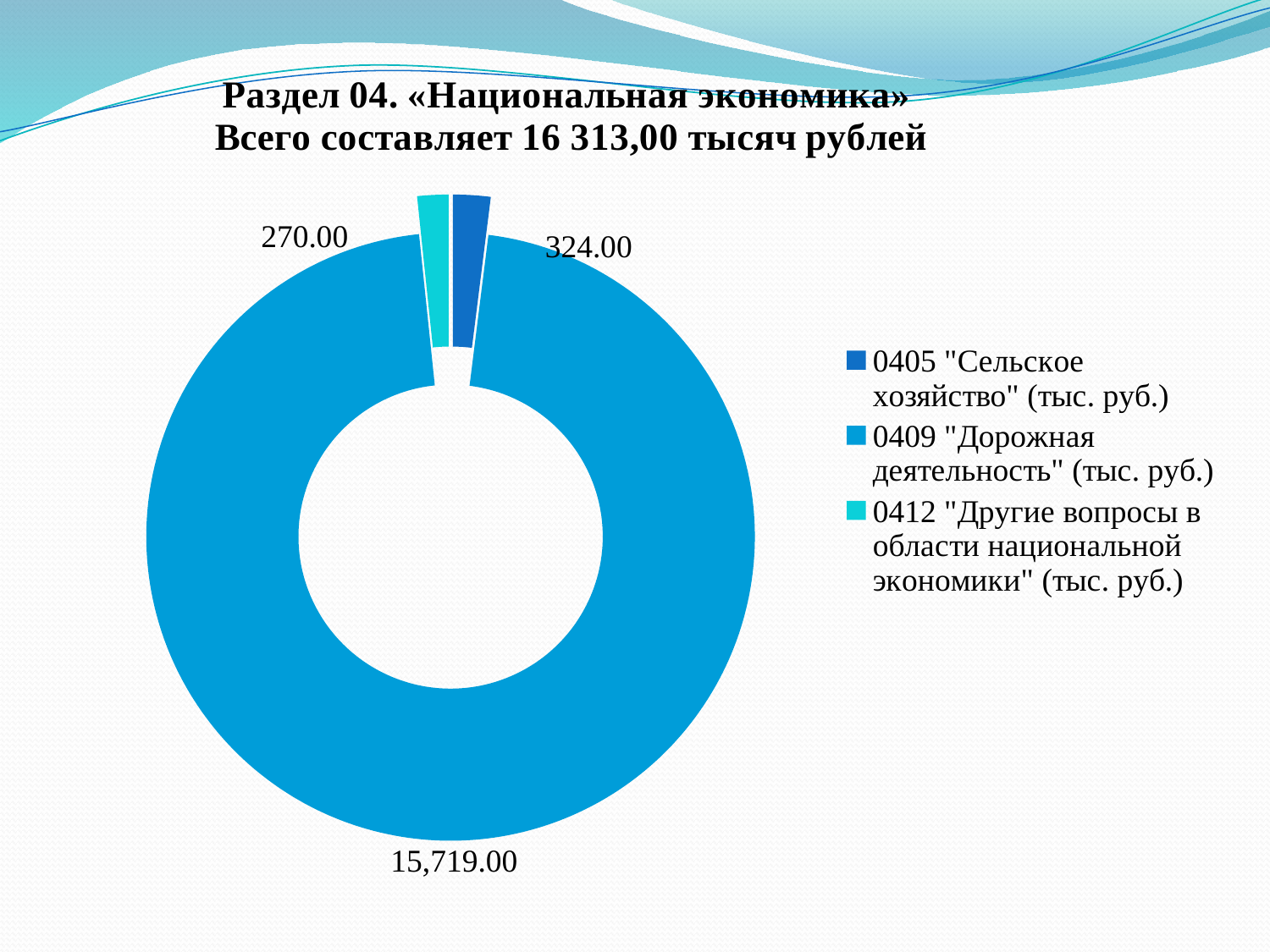
What is the value for 0405 "Сельское хозяйство" (тыс. руб.)? 324.00 Which category has the smallest value? 0412 "Другие вопросы в области национальной экономики" (тыс. руб.) Which is larger: the value for 0405 "Сельское хозяйство" or for 0412 "Другие вопросы в области национальной экономики"? 0405 "Сельское хозяйство" What is the value for 0412 "Другие вопросы в области национальной экономики" (тыс. руб.)? 270.00 Which category has the largest value? 0409 "Дорожная деятельность" (тыс. руб.) What total amount does the slide title state for Раздел 04 «Национальная экономика»? 16 313,00 тысяч рублей What is the value for 0409 "Дорожная деятельность" (тыс. руб.)? 15,719.00 What is the difference between the values for 0409 "Дорожная деятельность" and 0405 "Сельское хозяйство"? 15,395.00 What type of chart is shown on the slide? Doughnut (pie) chart What is the difference between the values for 0405 "Сельское хозяйство" and 0412 "Другие вопросы в области национальной экономики"? 54.00 How many categories does the chart show? 3 What colour is the slice for 0412 "Другие вопросы в области национальной экономики"? Cyan (light turquoise)